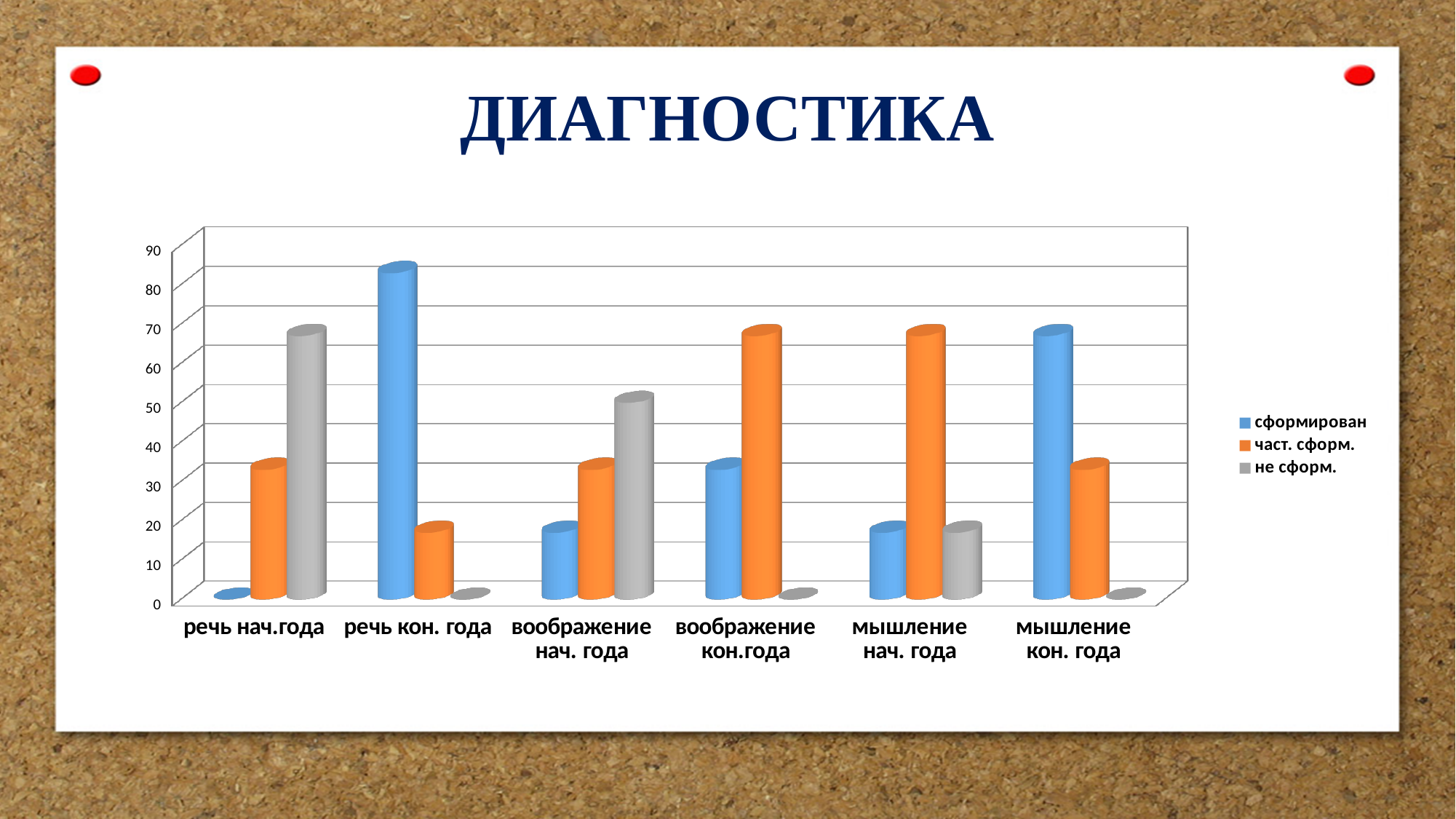
What is the title of the slide? ДИАГНОСТИКА Which category has the highest value for the series сформирован? речь кон. года Is the value of сформирован for речь кон. года greater or less than 70? greater Which category has the lowest value for the series сформирован? речь нач.года Which is larger: сформирован for речь кон. года or сформирован for мышление кон. года? речь кон. года How many series does the legend list? 3 What kind of chart is shown on the slide? bar chart Is the value of не сформ. for воображение нач. года greater or less than 40? greater Is the value of сформирован for воображение кон.года greater or less than 40? less Which category has the highest value for the series не сформ.? речь нач.года In the category воображение нач. года, which is larger: част. сформ. or не сформ.? не сформ. How many categories are shown on the x axis? 6